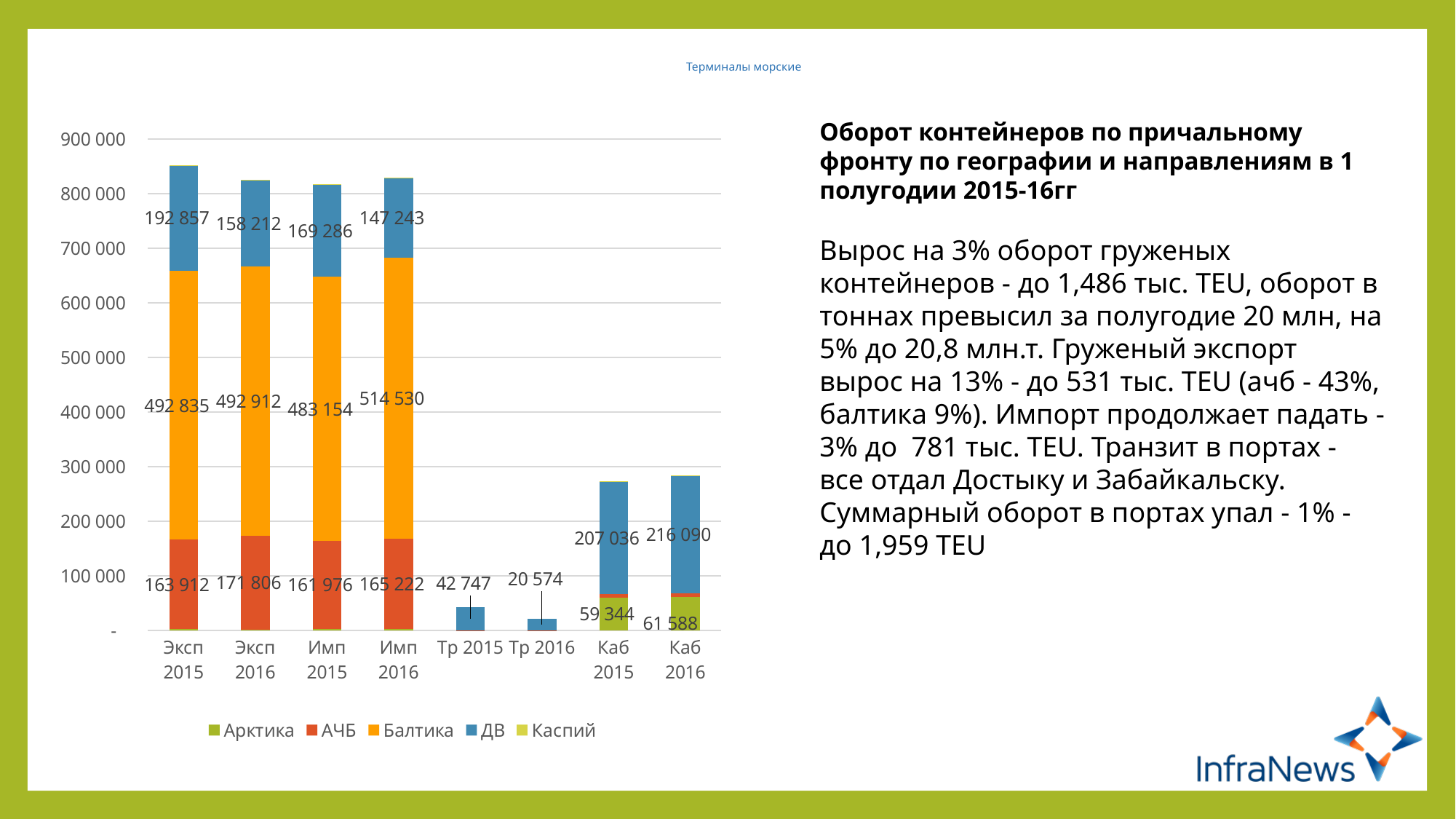
How many categories are shown on the x axis? 8 Which category has the lowest ДВ value? Тр 2016 What is the value of the Арктика segment for Каб 2015? 59 344 Which is larger, the Балтика value for Имп 2015 or for Имп 2016? Имп 2016 What is the value of the Балтика segment for Имп 2016? 514 530 What kind of chart is shown on the slide? Stacked bar chart Which category has the highest ДВ value? Каб 2016 What is the difference between the ДВ values for Эксп 2015 and Эксп 2016? 34 645 Is the total height of the Эксп 2015 bar greater or less than 800 000? greater What is the value of the АЧБ segment for Эксп 2016? 171 806 How many series does the legend list? 5 What is the value of the ДВ segment for Эксп 2015? 192 857